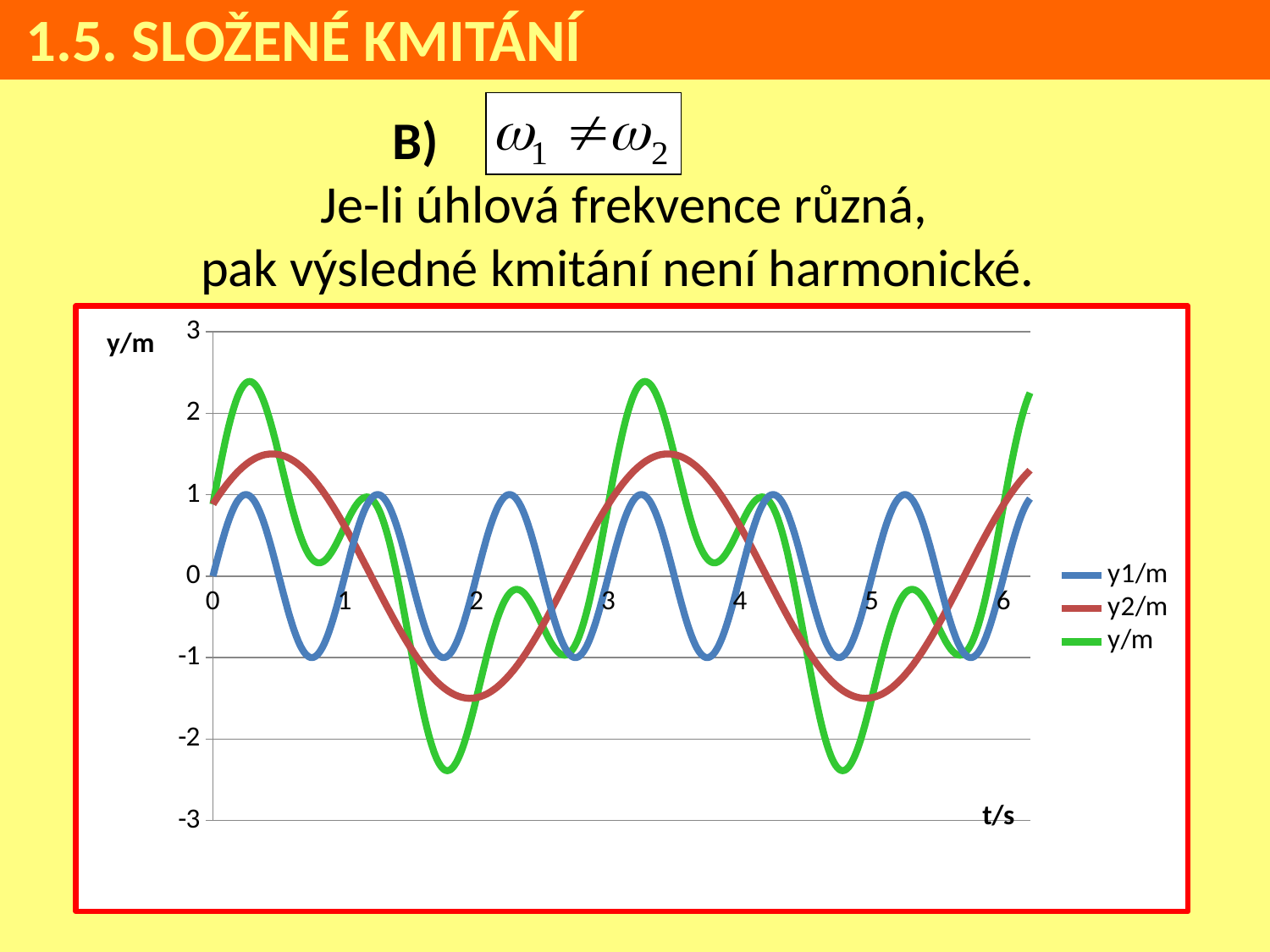
Is the lowest trough of the y/m series (near t = 2) greater or less than -2? less What is the minimum value reached by the y1/m series? -1 Which series reaches a higher peak value, y/m or y2/m? y/m What is the value of y1/m at t = 0? 0 Is the highest peak of the y2/m series greater or less than 1? greater Is the highest peak of the y2/m series greater or less than 2? less What are the series names listed in the legend? y1/m, y2/m, y/m What kind of chart is shown on the slide? line chart What is the label on the horizontal axis of the chart? t/s What is the maximum value reached by the y1/m series? 1 How many series does the legend list? 3